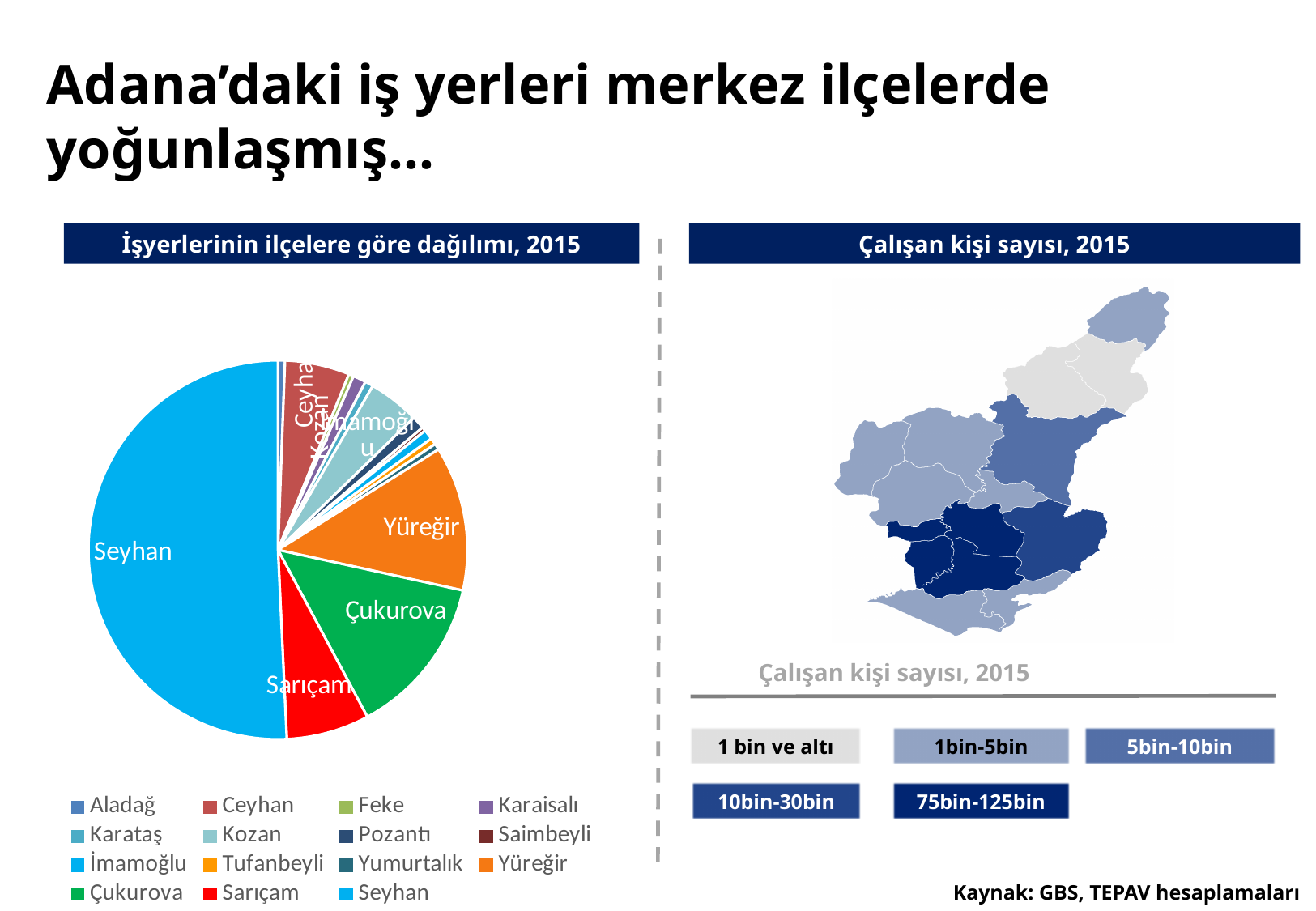
What kind of chart is the 'İşyerlerinin ilçelere göre dağılımı, 2015' chart? Pie chart How many districts does the legend of the 'İşyerlerinin ilçelere göre dağılımı, 2015' pie chart list? 15 What is the title of the chart on the left side of the slide? İşyerlerinin ilçelere göre dağılımı, 2015 In the 'İşyerlerinin ilçelere göre dağılımı, 2015' pie chart, which slice is larger, Çukurova or Sarıçam? Çukurova How many value classes does the legend of the 'Çalışan kişi sayısı, 2015' map show? 5 In the 'Çalışan kişi sayısı, 2015' map legend, which class is shown in the darkest blue? 75bin-125bin In the 'İşyerlerinin ilçelere göre dağılımı, 2015' pie chart, which slice is larger, Yüreğir or Ceyhan? Yüreğir In the 'İşyerlerinin ilçelere göre dağılımı, 2015' pie chart, which slice is larger, Seyhan or Yüreğir? Seyhan In the 'İşyerlerinin ilçelere göre dağılımı, 2015' pie chart, which district has the largest slice? Seyhan